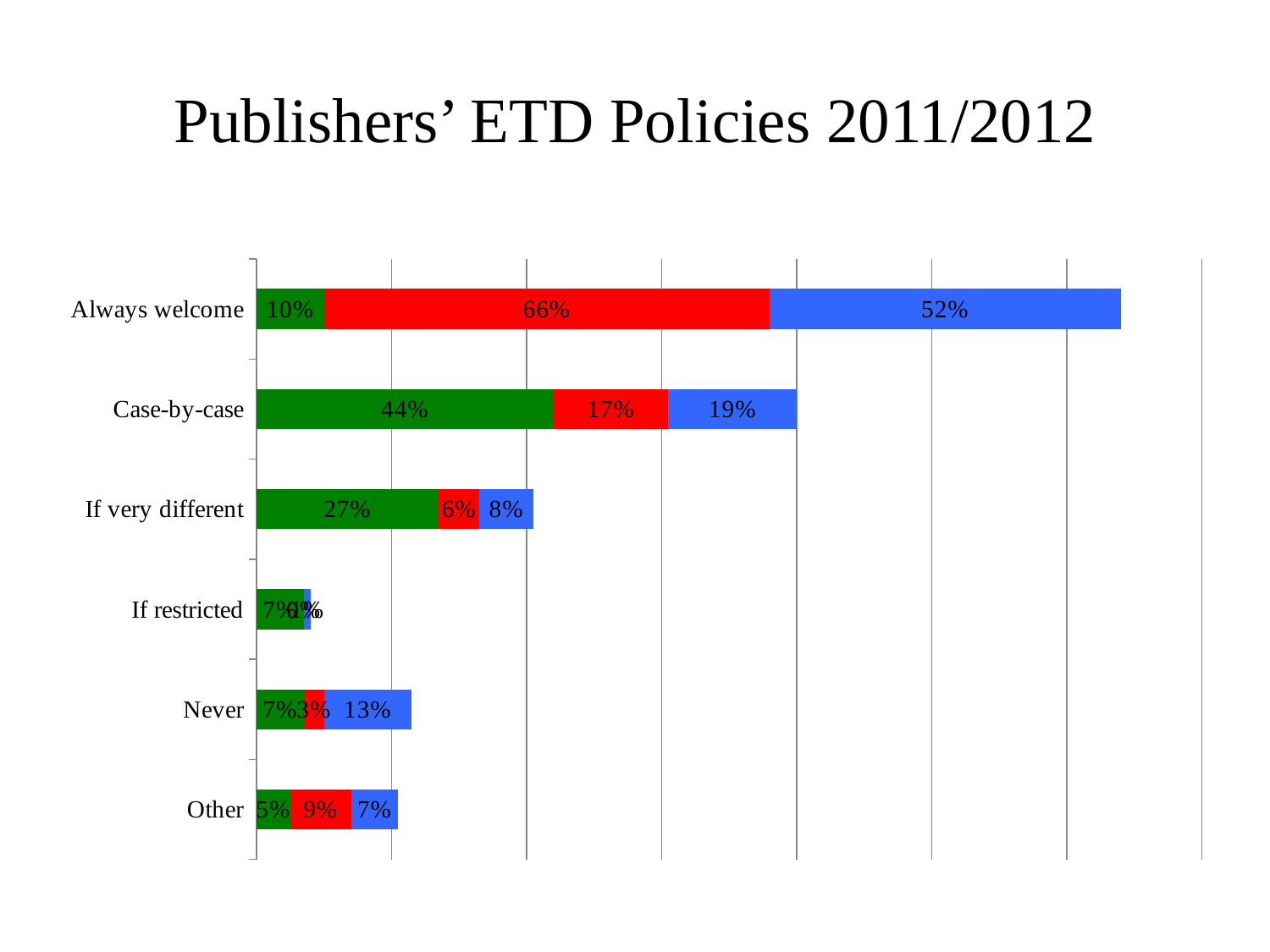
What is the value of the red segment for 'Other'? 9% What is the value of the red segment for 'Always welcome'? 66% Which category has the largest green segment? Case-by-case What is the value of the green segment for 'Case-by-case'? 44% Which is larger: the red segment for 'If very different' or the blue segment for 'If very different'? Blue (8%) How many categories are shown on the chart? 6 What is the total of the stacked bar for 'Case-by-case'? 80% What is the value of the blue segment for 'Never'? 13% What is the difference between the blue segment for 'Always welcome' and the blue segment for 'Case-by-case'? 33% What is the title of the chart? Publishers' ETD Policies 2011/2012 Which category has the largest blue segment? Always welcome What type of chart is shown on the slide? Stacked bar chart